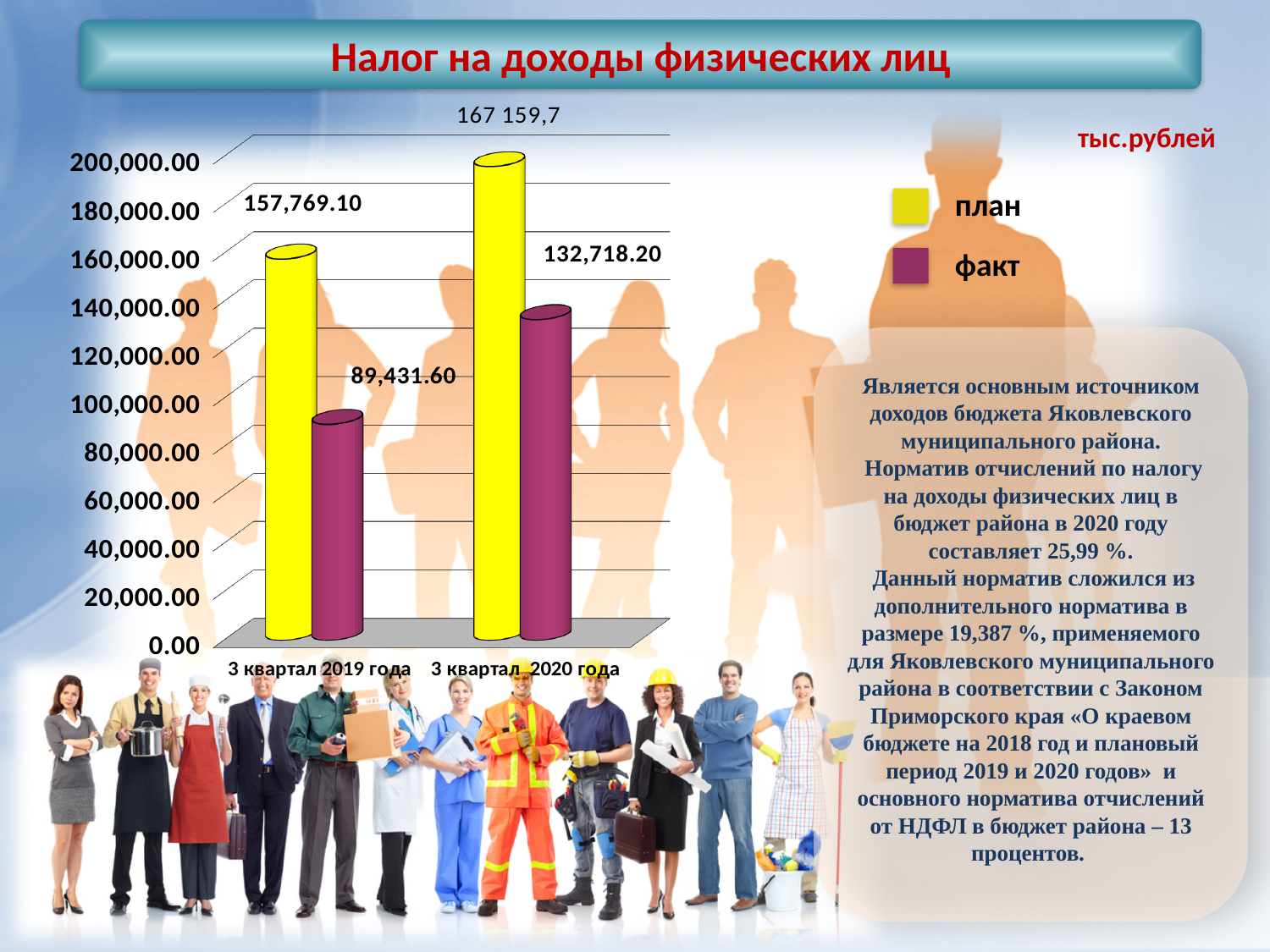
What type of chart is shown on the slide? bar chart What is the факт value for 3 квартал 2020 года? 132,718.20 What is the факт value for 3 квартал 2019 года? 89,431.60 What is the difference between the план and факт values for 3 квартал 2019 года? 68,337.50 How many categories are shown on the x axis of the chart? 2 Which colour represents the план series in the chart legend? yellow Does the факт value rise or fall from 3 квартал 2019 года to 3 квартал 2020 года? rise Which is larger: the факт value for 3 квартал 2019 года or the факт value for 3 квартал 2020 года? 3 квартал 2020 года How many series does the chart legend list? 2 Which bar in the chart is the lowest? факт, 3 квартал 2019 года What is the план value for 3 квартал 2019 года? 157,769.10